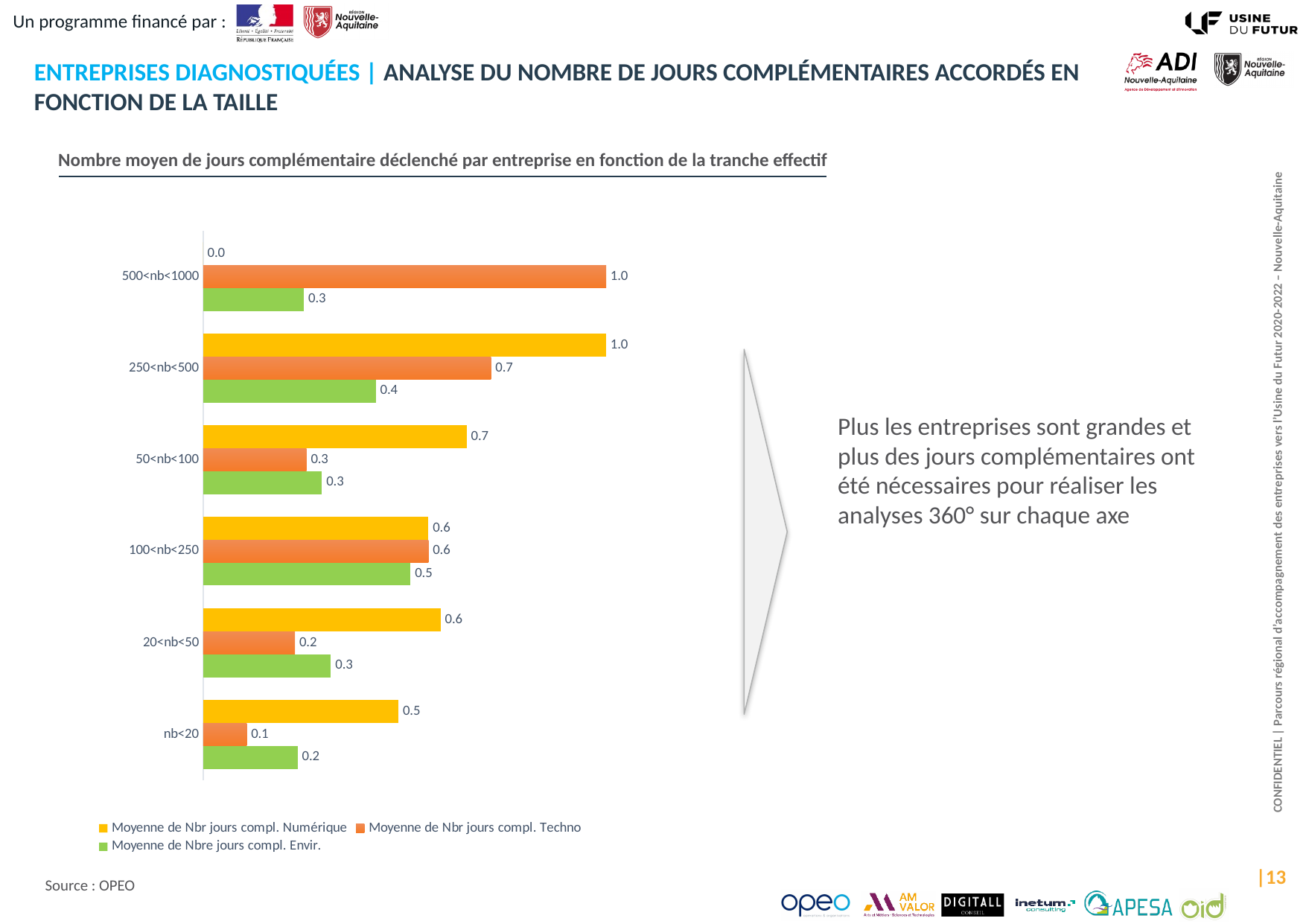
How many series does the legend list? 3 What is the value of 'Moyenne de Nbr jours compl. Numérique' for the 500<nb<1000 category? 0.0 What is the difference between the 'Moyenne de Nbr jours compl. Numérique' value for 250<nb<500 and for nb<20? 0.5 Which category has the lowest value for 'Moyenne de Nbr jours compl. Techno'? nb<20 For the 20<nb<50 category, which is larger: the Numérique value or the Techno value? Numérique What type of chart is shown on the slide? Bar chart What is the value of 'Moyenne de Nbre jours compl. Envir.' for the 100<nb<250 category? 0.5 What is the value of 'Moyenne de Nbr jours compl. Techno' for the 500<nb<1000 category? 1.0 How many size categories (tranches d'effectif) are shown on the chart? 6 Which colour represents 'Moyenne de Nbre jours compl. Envir.' in the chart? Green Which category has the highest value for 'Moyenne de Nbr jours compl. Numérique'? 250<nb<500 What is the value of 'Moyenne de Nbr jours compl. Numérique' for the nb<20 category? 0.5